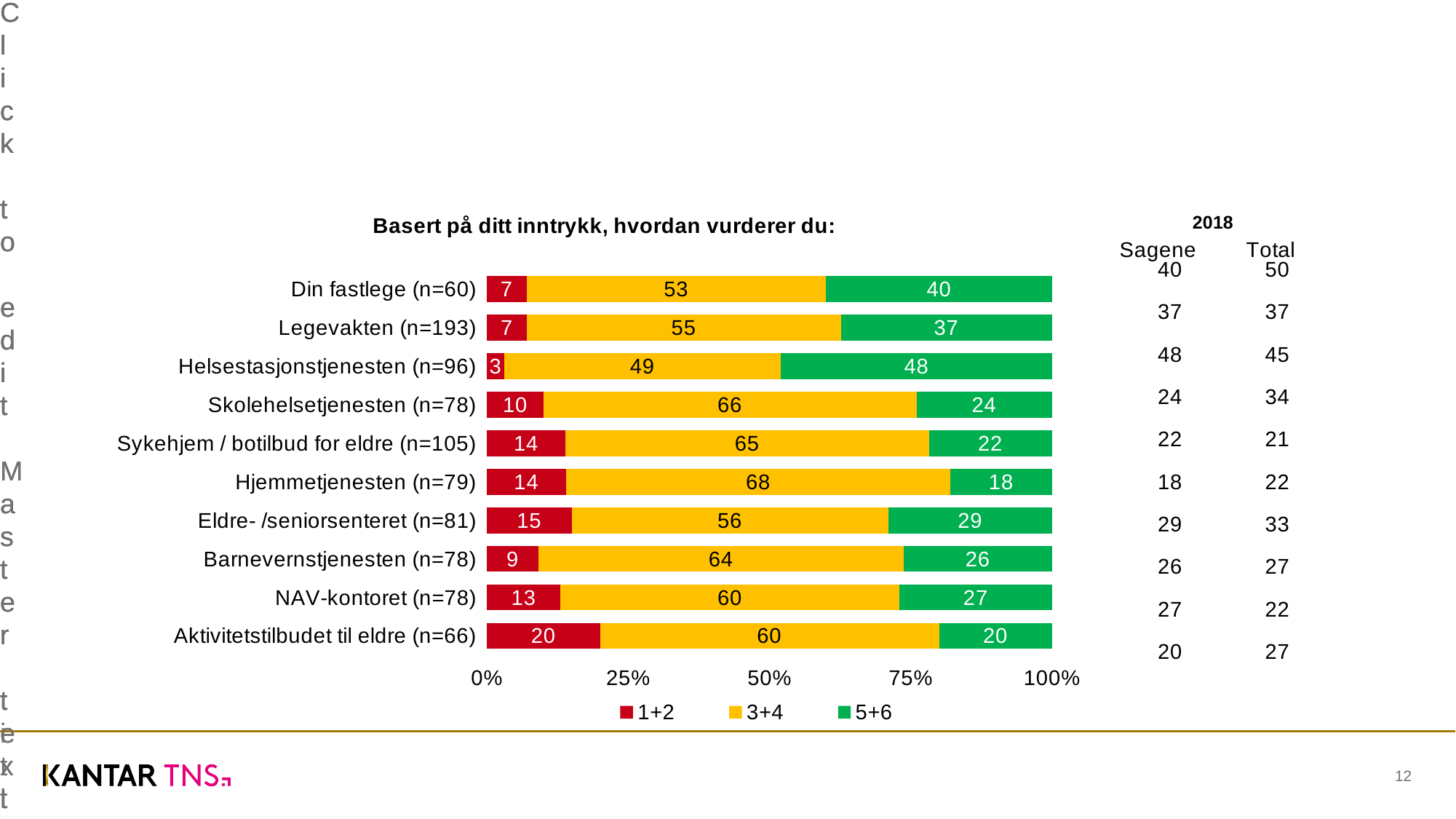
What is the title of the chart? Basert på ditt inntrykk, hvordan vurderer du: What is the 5+6 value for Helsestasjonstjenesten (n=96)? 48 Which has a larger 3+4 value, Skolehelsetjenesten (n=78) or Eldre- /seniorsenteret (n=81)? Skolehelsetjenesten (n=78) What is the total of the stacked bar for NAV-kontoret (n=78)? 100 How many categories (services) are plotted in the chart? 10 What is the 1+2 value for Aktivitetstilbudet til eldre (n=66)? 20 Which category has the highest 5+6 value? Helsestasjonstjenesten (n=96) What is the difference between the 5+6 values for Din fastlege (n=60) and Legevakten (n=193)? 3 How many series does the chart legend list? 3 What is the 3+4 value for Hjemmetjenesten (n=79)? 68 Which category has the lowest 1+2 value? Helsestasjonstjenesten (n=96) What kind of chart is shown on the slide? Stacked bar chart